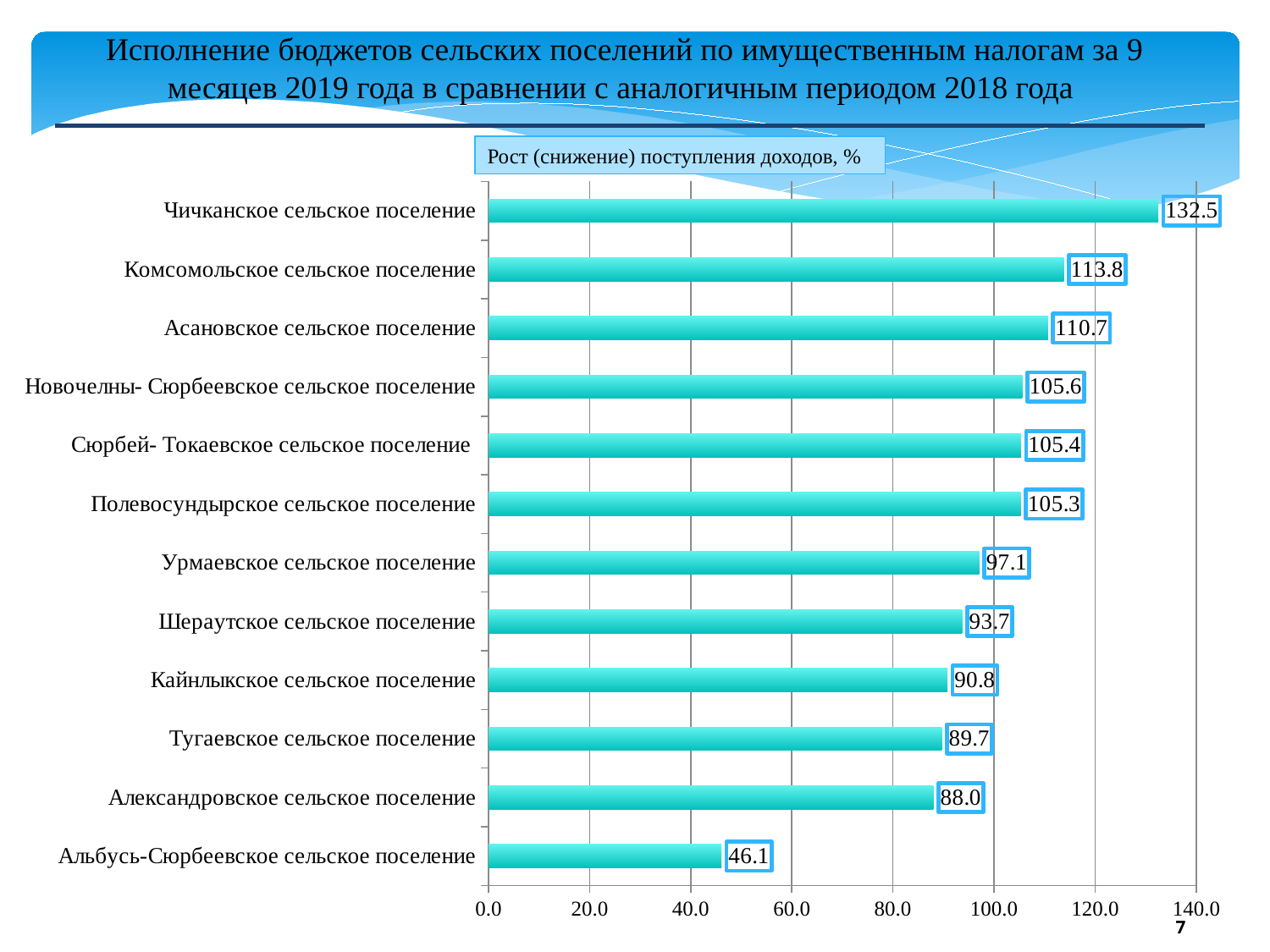
What is the value for Альбусь-Сюрбеевское сельское поселение? 46.1 Which has a larger value, Кайнлыкское сельское поселение or Тугаевское сельское поселение? Кайнлыкское сельское поселение How many settlements are shown in the chart? 12 Is the value for Александровское сельское поселение greater or less than 100.0? less Which settlement has the lowest value? Альбусь-Сюрбеевское сельское поселение What is the value for Чичканское сельское поселение? 132.5 What kind of chart is shown on the slide? bar chart What is the label shown in the legend box above the chart? Рост (снижение) поступления доходов, % What is the maximum value shown on the horizontal axis? 140.0 What is the difference between the values for Чичканское сельское поселение and Комсомольское сельское поселение? 18.7 What is the value for Урмаевское сельское поселение? 97.1 Which settlement has the highest value? Чичканское сельское поселение